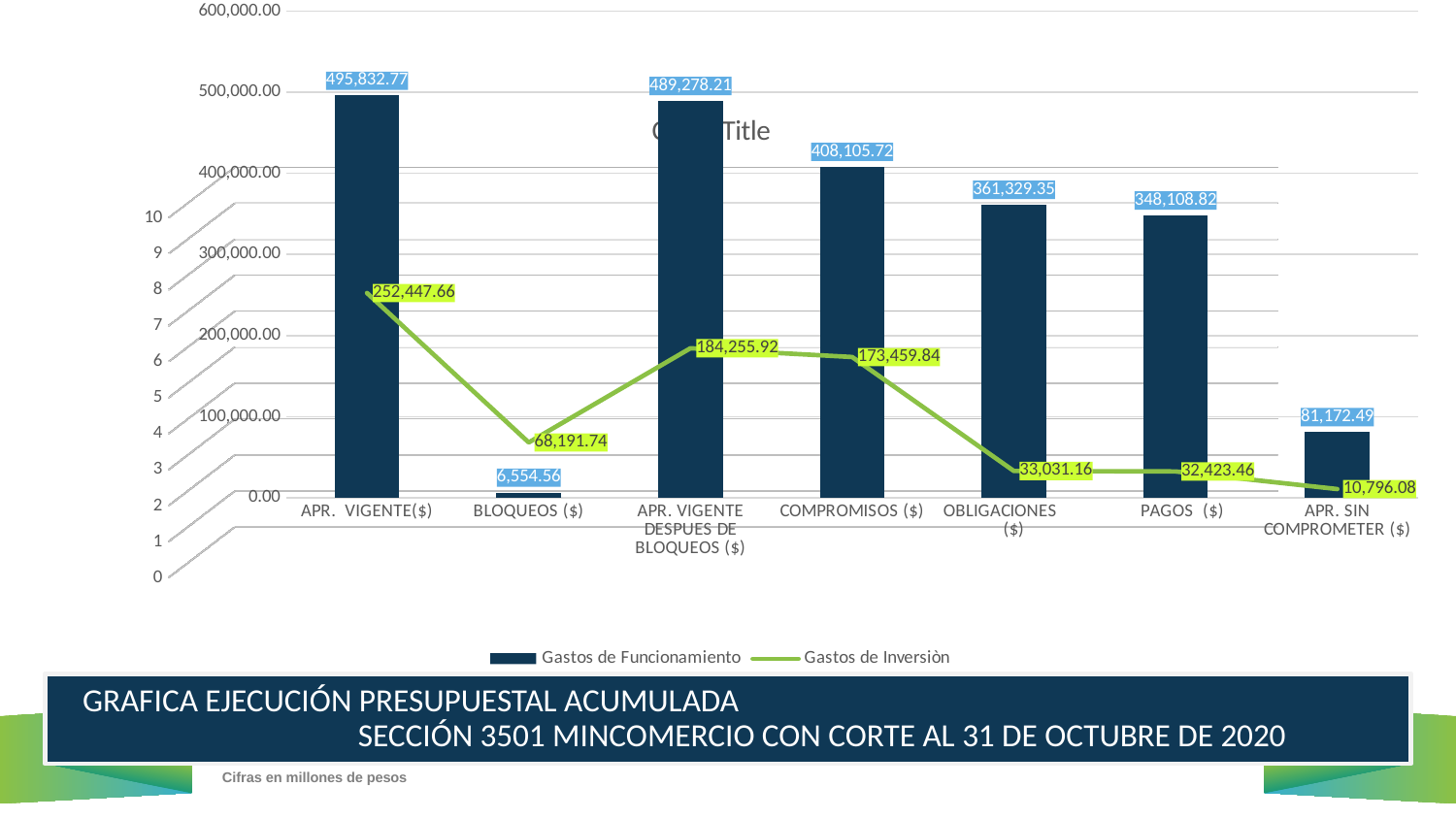
Which category has the highest Gastos de Inversión value? APR. VIGENTE($) How many series does the legend list? 2 How many categories are shown on the x axis of the chart? 7 What is the difference between the Gastos de Inversión values for COMPROMISOS ($) and OBLIGACIONES ($)? 140,428.68 Which category has the lowest Gastos de Funcionamiento value? BLOQUEOS ($) Which category has the highest Gastos de Funcionamiento value? APR. VIGENTE($) What is the Gastos de Inversión value for APR. SIN COMPROMETER ($)? 10,796.08 What is the Gastos de Funcionamiento value for COMPROMISOS ($)? 408,105.72 What is the Gastos de Inversión value for BLOQUEOS ($)? 68,191.74 Which has the larger Gastos de Funcionamiento value, OBLIGACIONES ($) or PAGOS ($)? OBLIGACIONES ($) What kind of chart is shown on the slide? A combined bar and line chart What is the difference between the Gastos de Funcionamiento values for APR. VIGENTE($) and APR. VIGENTE DESPUES DE BLOQUEOS ($)? 6,554.56